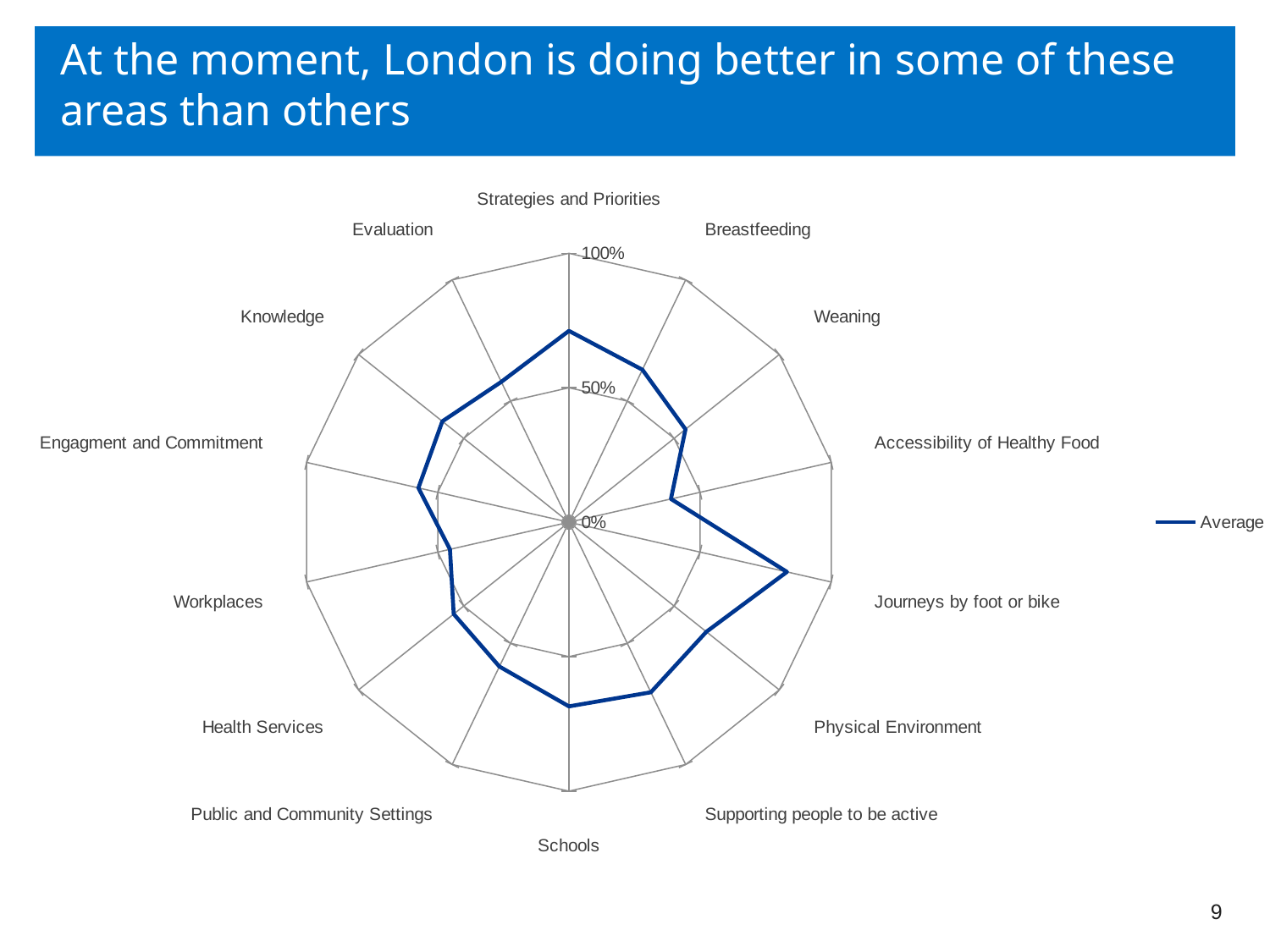
How many categories (axes) does the radar chart have? 14 Is the value for Accessibility of Healthy Food greater or less than 50%? less Is the value for Strategies and Priorities greater or less than 50%? greater How many series does the legend list? 1 Which is larger, the value for Strategies and Priorities or the value for Accessibility of Healthy Food? Strategies and Priorities What is the name of the series shown in the legend? Average Which is larger, the value for Journeys by foot or bike or the value for Workplaces? Journeys by foot or bike Is the value for Workplaces greater or less than 50%? less What kind of chart is shown on the slide? Radar chart Which category has the highest value on the chart? Journeys by foot or bike